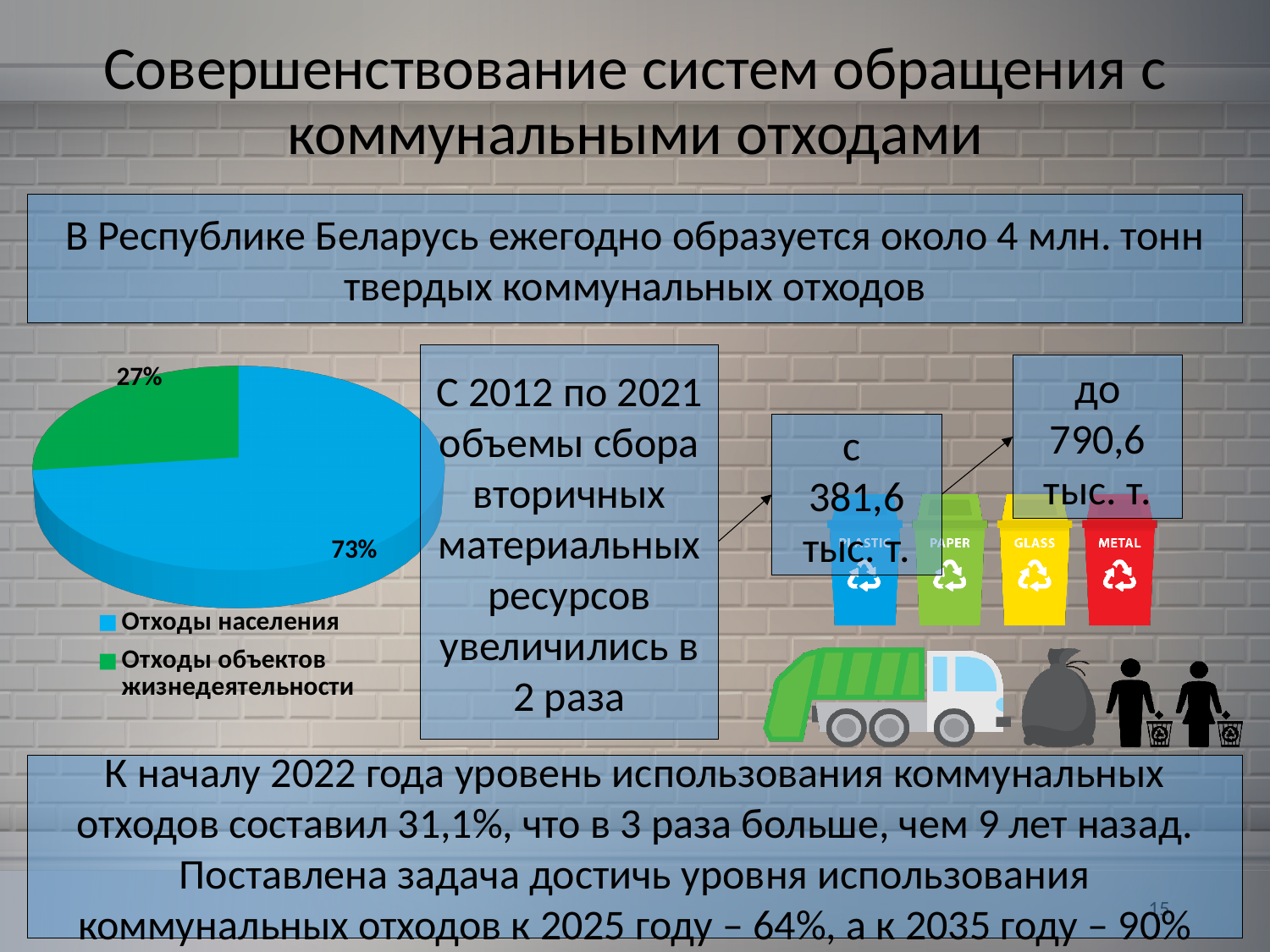
How many entries does the legend of the pie chart list? 2 What share of the pie does "Отходы населения" represent? 73% Which category has the smallest slice in the pie chart? Отходы объектов жизнедеятельности What colour is the slice for "Отходы объектов жизнедеятельности" in the pie chart? green What kind of chart is shown on the left of the slide? pie chart How many slices does the pie chart have? 2 What share of the pie does "Отходы объектов жизнедеятельности" represent? 27% Which category has the largest slice in the pie chart? Отходы населения What is the total of the two slices shown in the pie chart? 100% What colour is the slice for "Отходы населения" in the pie chart? blue Which is larger: the slice for "Отходы населения" or the slice for "Отходы объектов жизнедеятельности"? Отходы населения What is the difference in percentage points between "Отходы населения" and "Отходы объектов жизнедеятельности"? 46